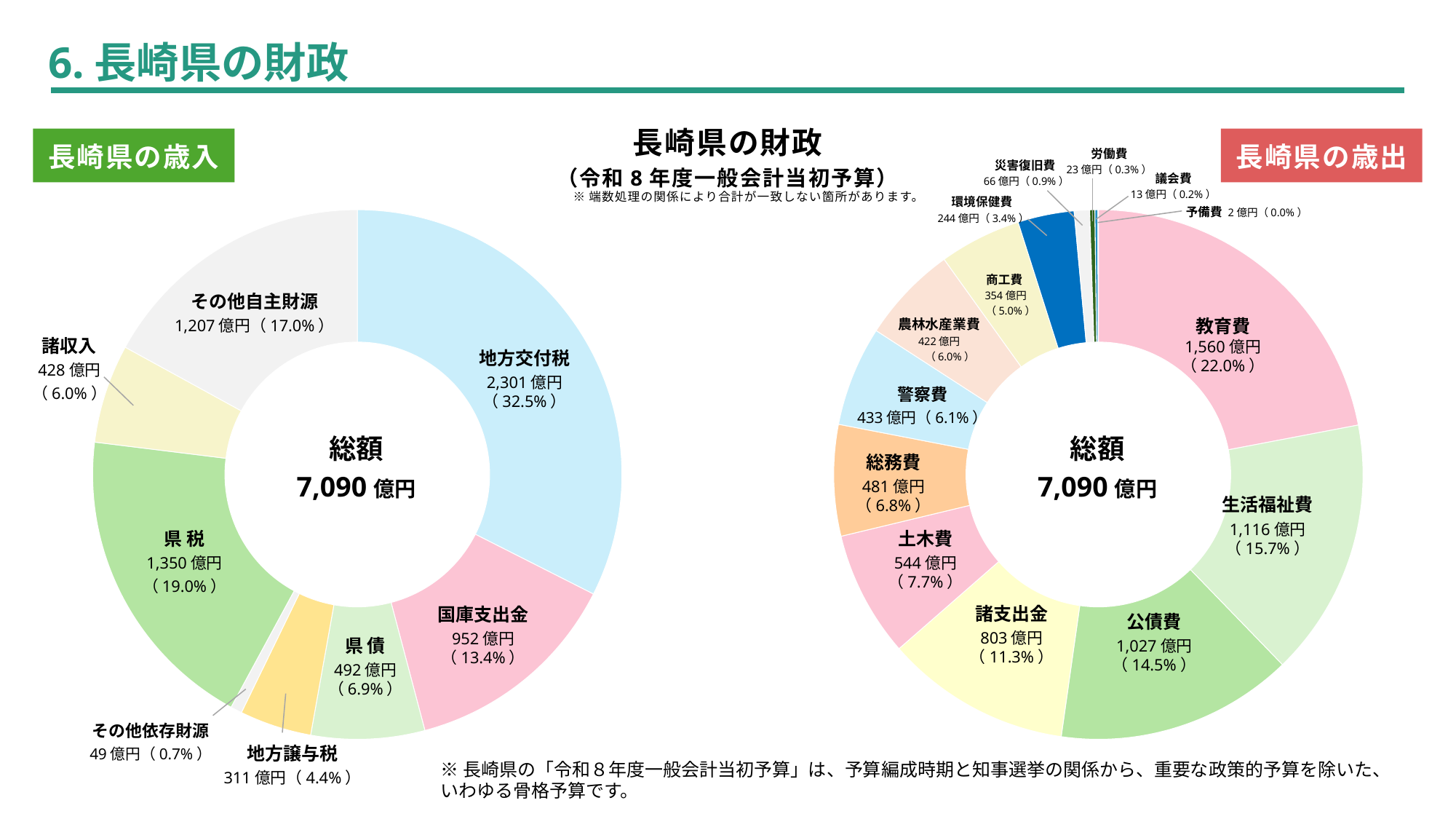
In the 長崎県の歳入 chart, how many categories are shown? 8 What total amount is shown in the centre of the 長崎県の歳入 chart? 7,090 億円 In the 長崎県の歳入 chart, what is the difference between 県税 and 国庫支出金? 398 億円 In the 長崎県の歳出 chart, which is larger, 公債費 or 生活福祉費? 生活福祉費 In the 長崎県の歳入 chart, which category has the smallest value? その他依存財源 In the 長崎県の歳出 chart, which category has the largest value? 教育費 What kind of chart is used for 長崎県の歳出? Donut (pie) chart In the 長崎県の歳出 chart, how many categories are shown? 14 In the 長崎県の歳入 chart, what share of the total does 県税 represent? 19.0% In the 長崎県の歳入 chart, what is the value for 地方交付税? 2,301 億円 In the 長崎県の歳出 chart, what share of the total does 諸支出金 represent? 11.3% In the 長崎県の歳出 chart, what is the value for 教育費? 1,560 億円